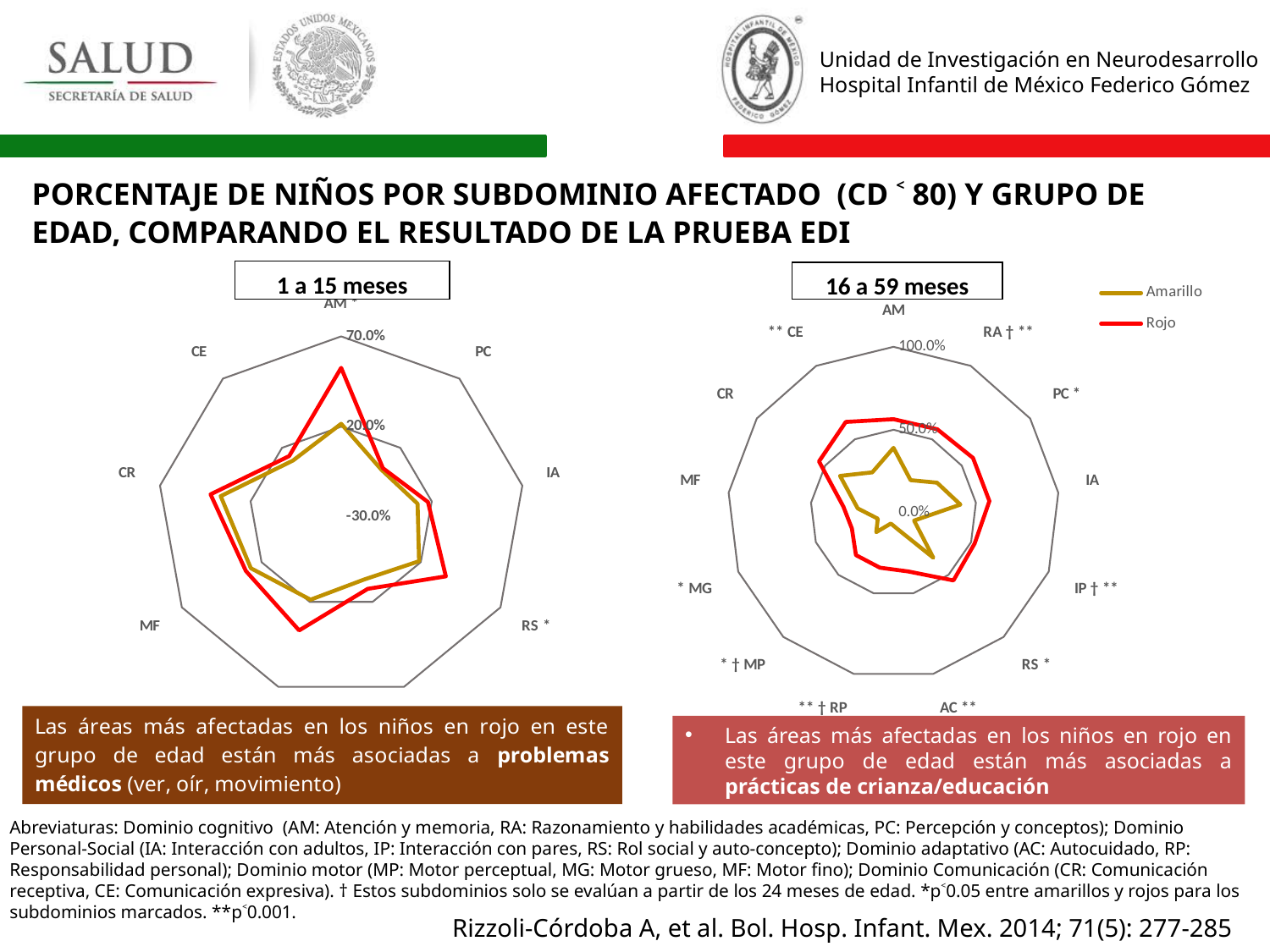
What kind of chart is the "16 a 59 meses" chart? Radar chart In the "16 a 59 meses" chart, is the Amarillo value for IA greater or less than 50.0%? less What kind of chart is the "1 a 15 meses" chart? Radar chart In the "16 a 59 meses" chart, is the Amarillo value for AM greater or less than 50.0%? less In the "1 a 15 meses" chart, which series has the larger value for AM, Amarillo or Rojo? Rojo How many series does the legend list for the charts? 2 In the "16 a 59 meses" chart, which series has the larger value for RA, Amarillo or Rojo? Rojo In the "1 a 15 meses" chart, is the Rojo value for AM greater or less than 20.0%? greater What are the two series named in the legend? Amarillo and Rojo What colour is the Rojo series drawn in? Red How many subdomain categories are plotted on the "1 a 15 meses" chart? 9 How many subdomain categories are plotted on the "16 a 59 meses" chart? 13